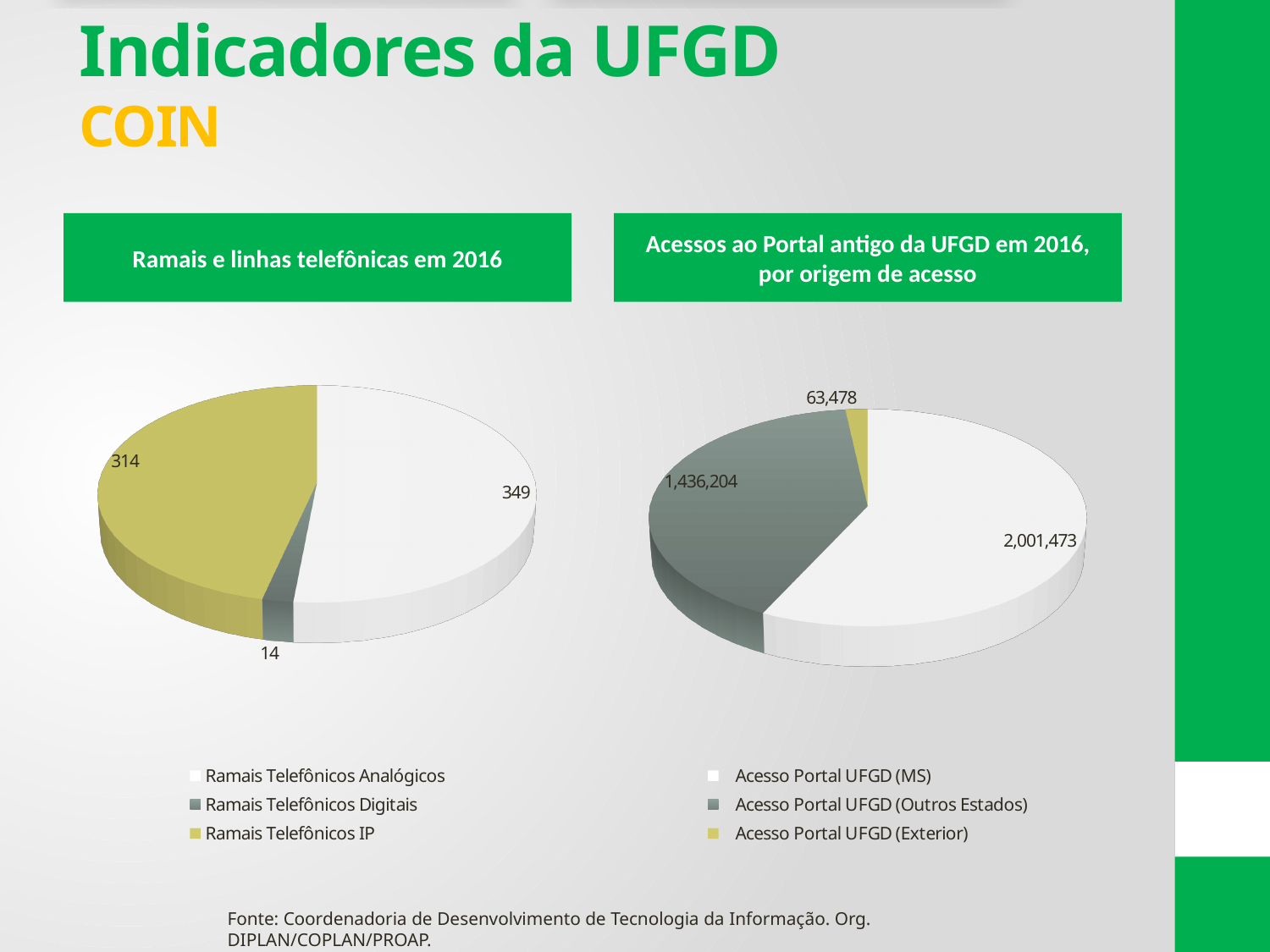
In the 'Acessos ao Portal antigo da UFGD em 2016' chart, which origin has the largest number of accesses? Acesso Portal UFGD (MS) In the 'Ramais e linhas telefônicas em 2016' chart, what is the total of all three categories? 677 In the 'Acessos ao Portal antigo da UFGD em 2016' chart, what is the value for Acesso Portal UFGD (Outros Estados)? 1,436,204 In the 'Acessos ao Portal antigo da UFGD em 2016' chart, what is the difference between Acesso Portal UFGD (MS) and Acesso Portal UFGD (Outros Estados)? 565,269 In the 'Acessos ao Portal antigo da UFGD em 2016' chart, which is larger: Acesso Portal UFGD (Outros Estados) or Acesso Portal UFGD (Exterior)? Acesso Portal UFGD (Outros Estados) In the 'Ramais e linhas telefônicas em 2016' chart, which category has the smallest slice? Ramais Telefônicos Digitais In the 'Ramais e linhas telefônicas em 2016' chart, what is the value for Ramais Telefônicos Digitais? 14 In the 'Acessos ao Portal antigo da UFGD em 2016' chart, what is the value for Acesso Portal UFGD (Exterior)? 63,478 In the 'Ramais e linhas telefônicas em 2016' chart, what is the difference between Ramais Telefônicos Analógicos and Ramais Telefônicos IP? 35 What kind of chart is used for 'Ramais e linhas telefônicas em 2016'? Pie chart How many categories does the legend of the 'Acessos ao Portal antigo da UFGD em 2016' chart list? 3 In the 'Ramais e linhas telefônicas em 2016' chart, what is the value for Ramais Telefônicos Analógicos? 349